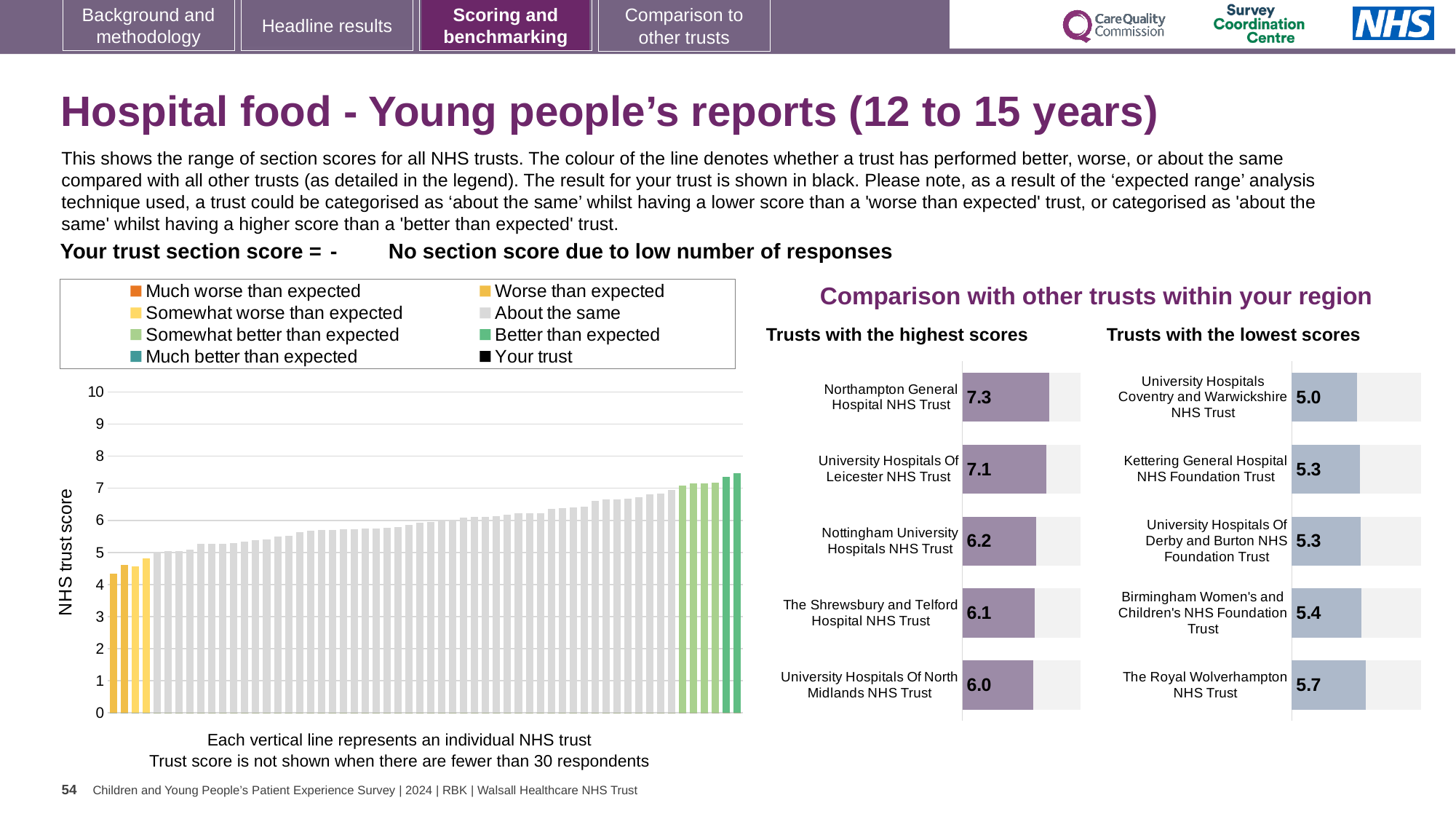
In the 'Trusts with the highest scores' chart, what is the difference between the scores of Northampton General Hospital NHS Trust and University Hospitals Of North Midlands NHS Trust? 1.3 In the 'Trusts with the lowest scores' chart, what is the score for University Hospitals Coventry and Warwickshire NHS Trust? 5.0 In the 'Trusts with the highest scores' chart, which trust has the highest score? Northampton General Hospital NHS Trust In the 'Trusts with the lowest scores' chart, what is the score for Birmingham Women's and Children's NHS Foundation Trust? 5.4 What kind of chart is the 'NHS trust score' chart on the left of the slide? Bar chart How many trusts are shown in the 'Trusts with the highest scores' chart? 5 How many entries does the legend above the 'NHS trust score' chart list? 8 In the 'NHS trust score' chart on the left, do the bar values rise or fall from left to right? Rise In the 'Trusts with the lowest scores' chart, which has the larger score: Kettering General Hospital NHS Foundation Trust or The Royal Wolverhampton NHS Trust? The Royal Wolverhampton NHS Trust In the 'Trusts with the highest scores' chart, what is the score for Northampton General Hospital NHS Trust? 7.3 In the 'Trusts with the lowest scores' chart, which trust has the lowest score? University Hospitals Coventry and Warwickshire NHS Trust In the 'NHS trust score' chart on the left, is the value of the leftmost bar greater or less than 5? less